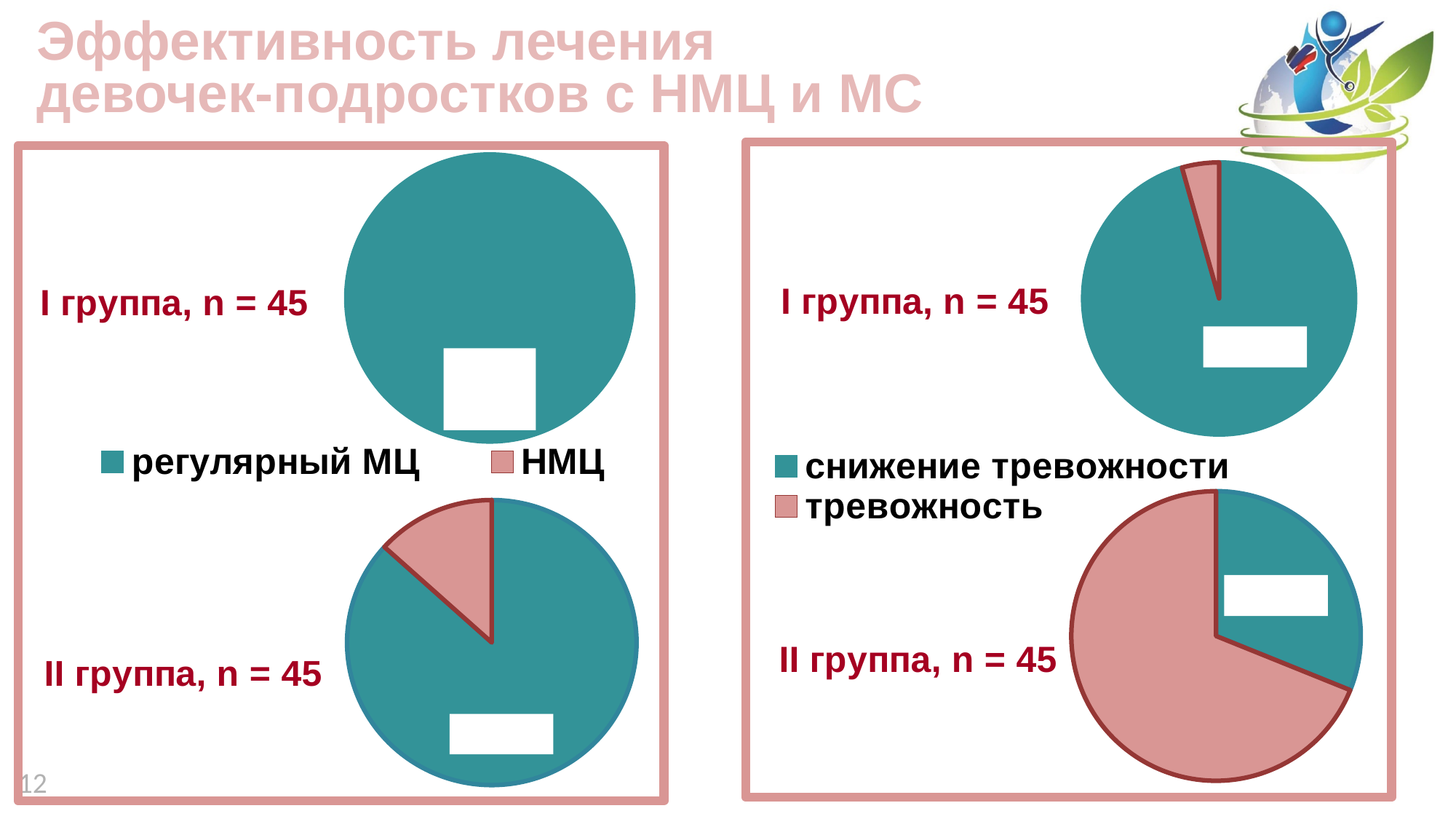
What are the two legend entries in the right panel? снижение тревожности, тревожность How many series does the legend in the left panel list? 2 In the right panel pie for I группа, n = 45, which slice is larger: снижение тревожности or тревожность? снижение тревожности Is the share of тревожность in the right panel pie for II группа, n = 45 greater or less than 50%? greater Which colour represents НМЦ in the left panel legend? pink How many series does the legend in the right panel list? 2 In the left panel pie for I группа, n = 45, which category takes up the whole pie? регулярный МЦ In the left panel pie for II группа, n = 45, which slice is larger: регулярный МЦ or НМЦ? регулярный МЦ How many pie charts are shown on the slide in total? 4 In the right panel pie for II группа, n = 45, which category has the smallest slice? снижение тревожности In the right panel pie for II группа, n = 45, which slice is larger: снижение тревожности or тревожность? тревожность What kind of chart is used in the left panel for I группа, n = 45? pie chart